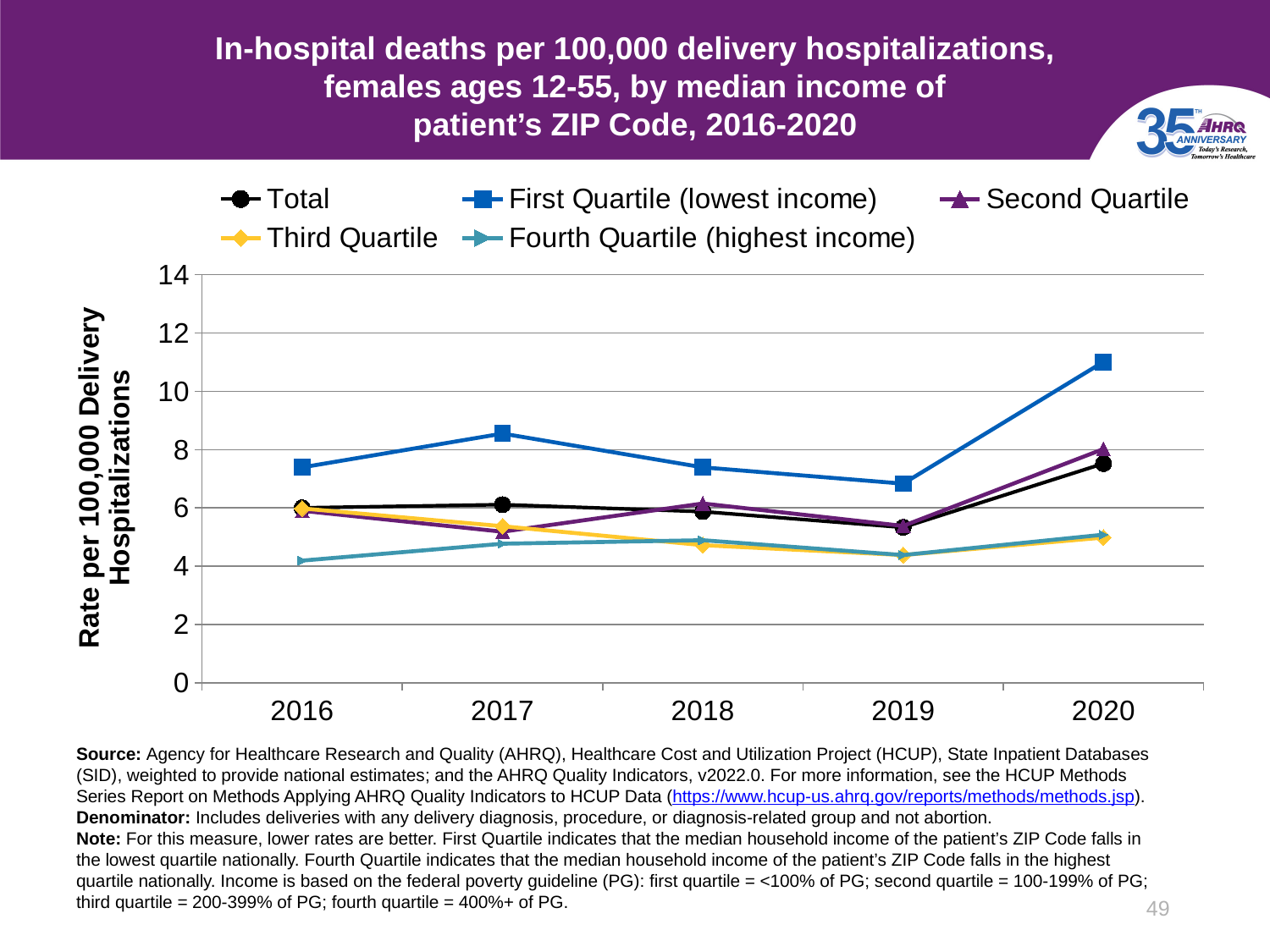
In 2019, which is larger: the value for First Quartile (lowest income) or the value for Total? First Quartile (lowest income) What is the label on the y axis of the chart? Rate per 100,000 Delivery Hospitalizations Which series has the highest value in 2020? First Quartile (lowest income) In which year does the First Quartile (lowest income) series reach its highest value? 2020 Does the First Quartile (lowest income) line rise or fall from 2019 to 2020? rise How many years are plotted along the x axis? 5 Is the value for Fourth Quartile (highest income) in 2016 greater or less than 6? less How many series does the legend list? 5 Is the value for First Quartile (lowest income) in 2017 greater or less than 8? greater What kind of chart is shown on the slide? Line chart Which series has the lowest value in 2016? Fourth Quartile (highest income) Is the value for First Quartile (lowest income) in 2020 greater or less than 10? greater